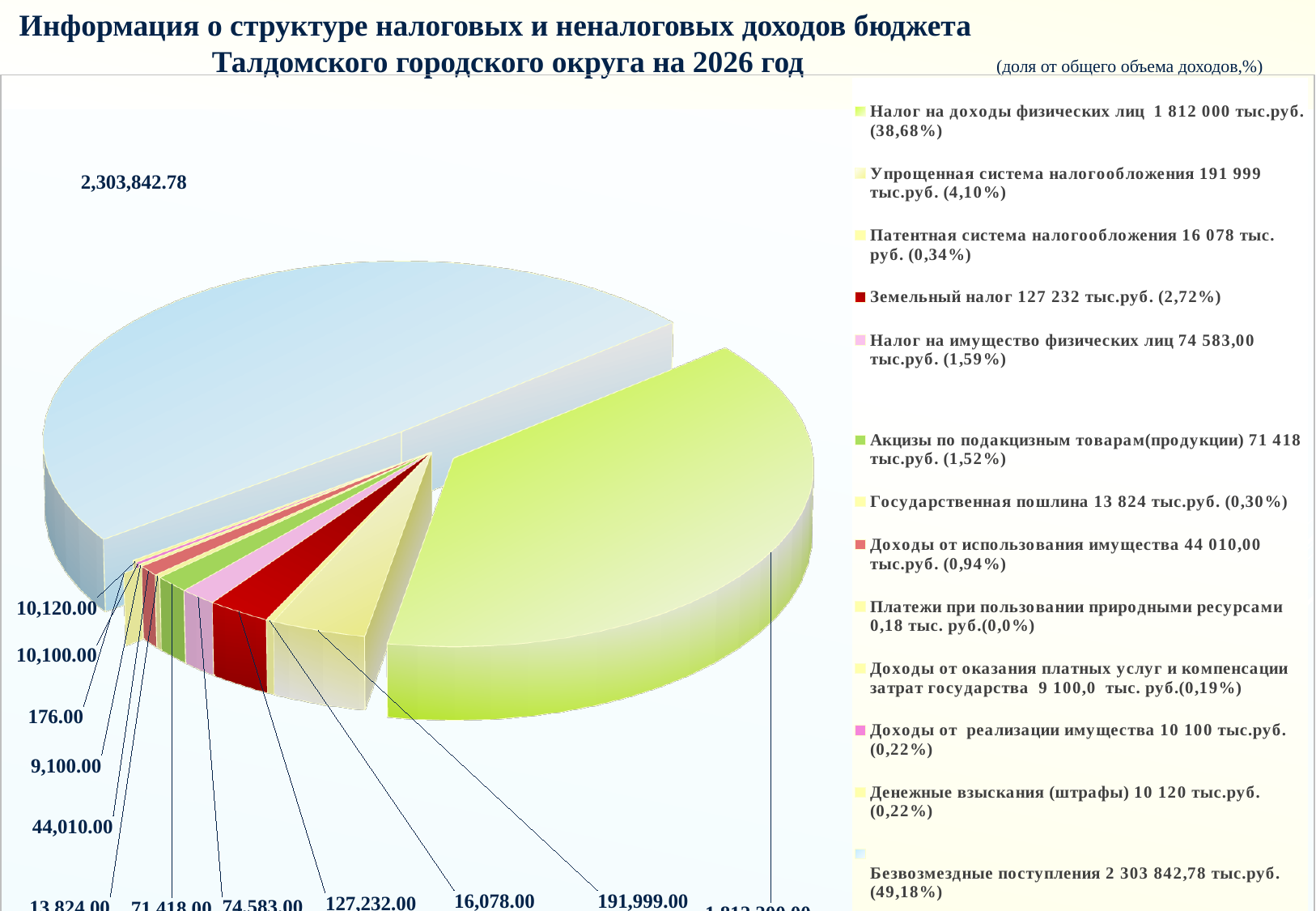
What share of total revenue does Налог на доходы физических лиц represent according to the legend? 38,68% What value is labelled for Акцизы по подакцизным товарам on the pie chart? 71,418.00 Which category has the largest slice of the pie chart? Безвозмездные поступления What value is labelled for Земельный налог on the pie chart? 127,232.00 What kind of chart is shown on the slide? pie chart What share of total revenue does Государственная пошлина represent according to the legend? 0,30% What value is labelled for Безвозмездные поступления on the pie chart? 2,303,842.78 What share of total revenue does Безвозмездные поступления represent according to the legend? 49,18% What is the difference between the labelled values for Упрощенная система налогообложения (191,999.00) and Патентная система налогообложения (16,078.00)? 175,921.00 Which is larger: Земельный налог or Налог на имущество физических лиц? Земельный налог How many categories does the legend of the pie chart list? 13 Which category has the smallest share in the pie chart? Платежи при пользовании природными ресурсами